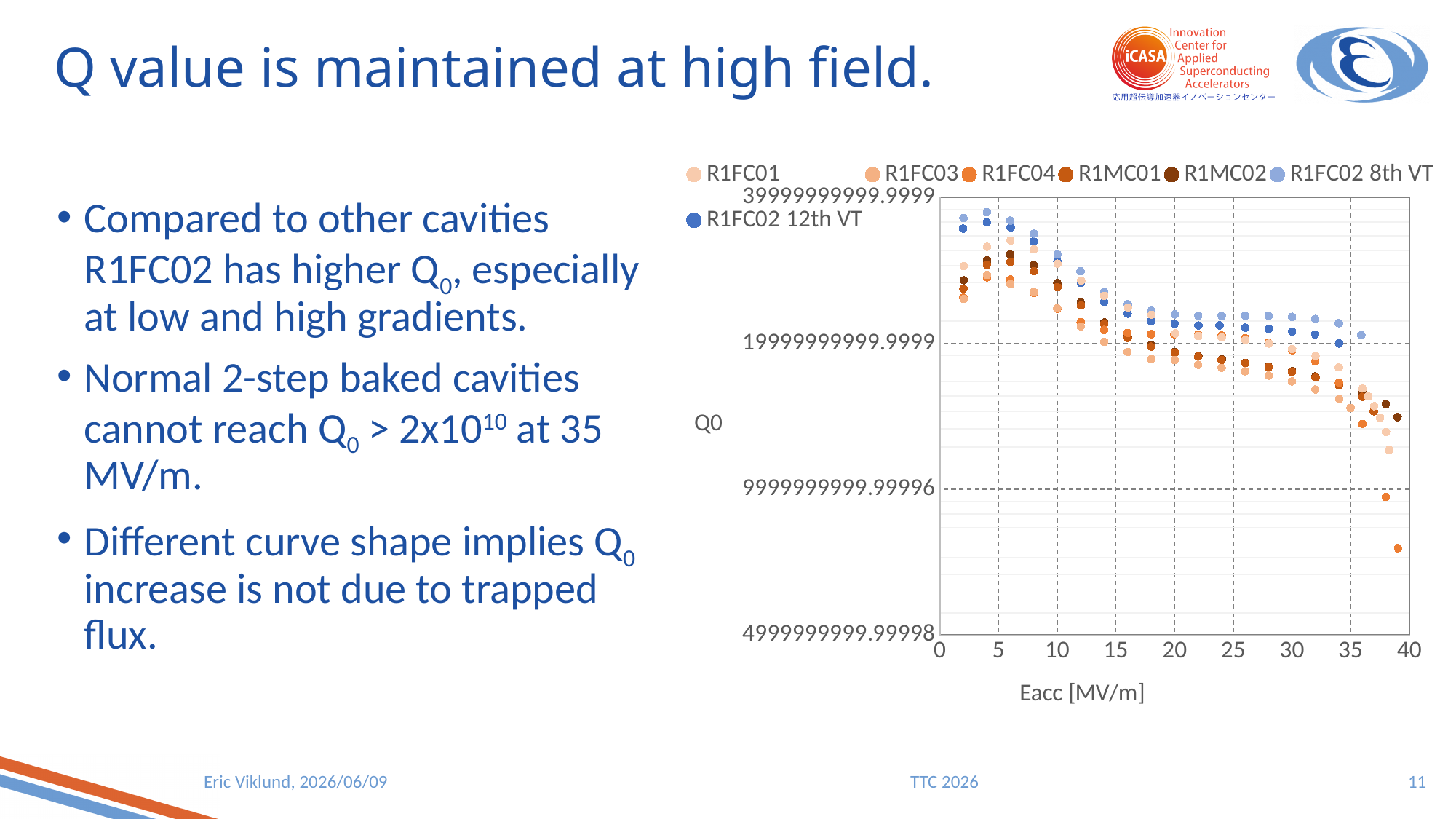
How many series does the chart legend list? 7 At 35 MV/m, which series has the higher Q0: R1FC02 8th VT or R1FC04? R1FC02 8th VT What is the maximum value shown on the x axis of the chart? 40 What is the label of the y axis of the chart? Q0 What kind of chart is shown on the slide? scatter chart Is the Q0 value for R1FC02 8th VT at 35 MV/m greater or less than 19999999999.9999? greater Is the Q0 value for R1FC02 12th VT at 5 MV/m greater or less than 19999999999.9999? greater What is the label of the x axis of the chart? Eacc [MV/m] Overall, do the Q0 values rise or fall as Eacc increases along the x axis? fall Is the lowest Q0 point for R1FC04 (near 39 MV/m) greater or less than 9999999999.99996? less Which series has the lowest Q0 point on the chart? R1FC04